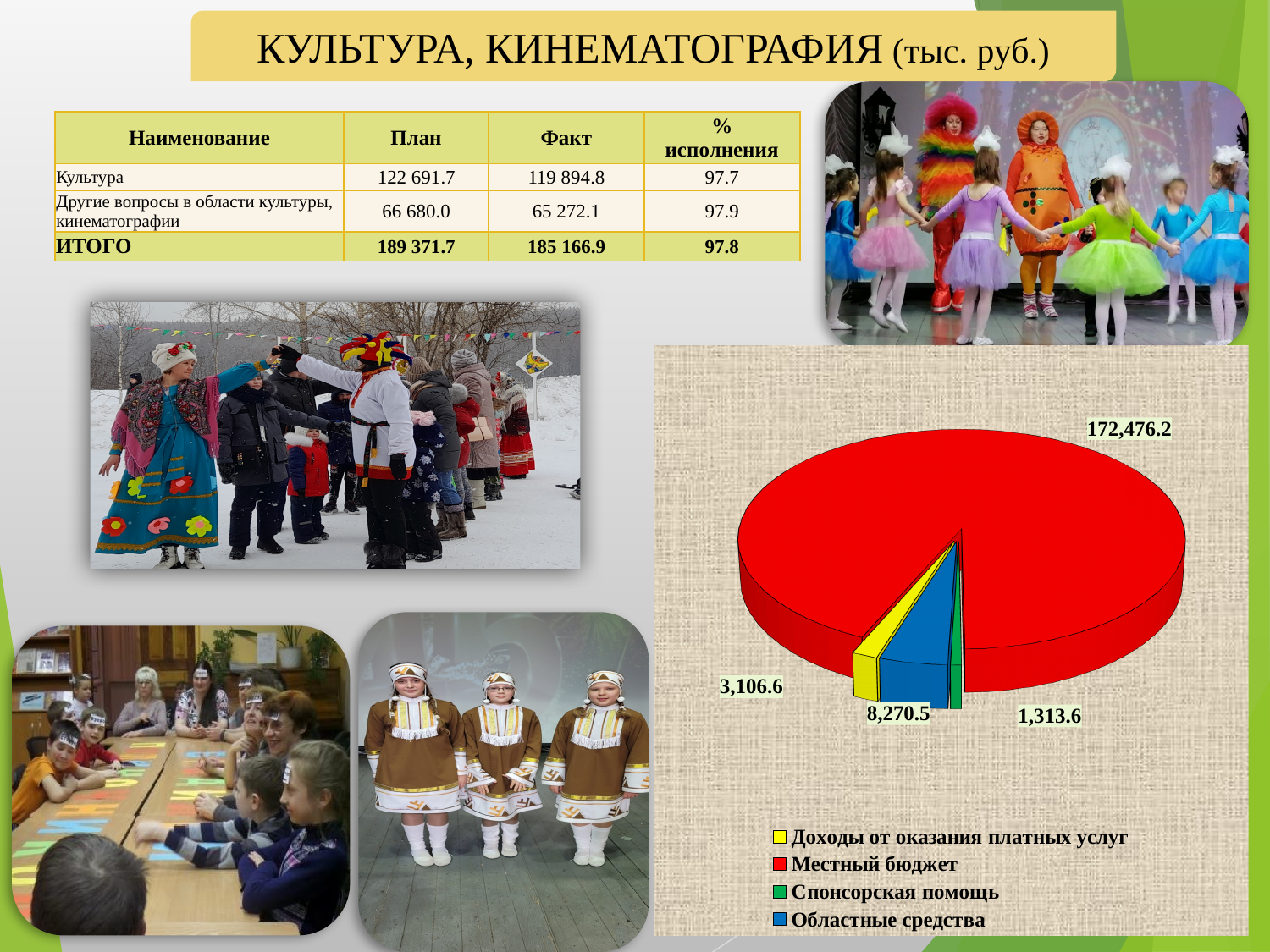
What is the value of the Спонсорская помощь slice in the pie chart? 1,313.6 Which category has the smallest slice in the pie chart? Спонсорская помощь How many slices does the pie chart have? 4 What is the value of the Доходы от оказания платных услуг slice in the pie chart? 3,106.6 Which category has the largest slice in the pie chart? Местный бюджет What is the total of all slices in the pie chart? 185,166.9 What type of chart is shown on the slide? Pie chart What is the value of the Областные средства slice in the pie chart? 8,270.5 What colour is the Местный бюджет slice in the pie chart? Red What is the difference between the Областные средства and Доходы от оказания платных услуг values in the pie chart? 5,163.9 Which is larger in the pie chart: Областные средства or Доходы от оказания платных услуг? Областные средства What is the value of the Местный бюджет slice in the pie chart? 172,476.2